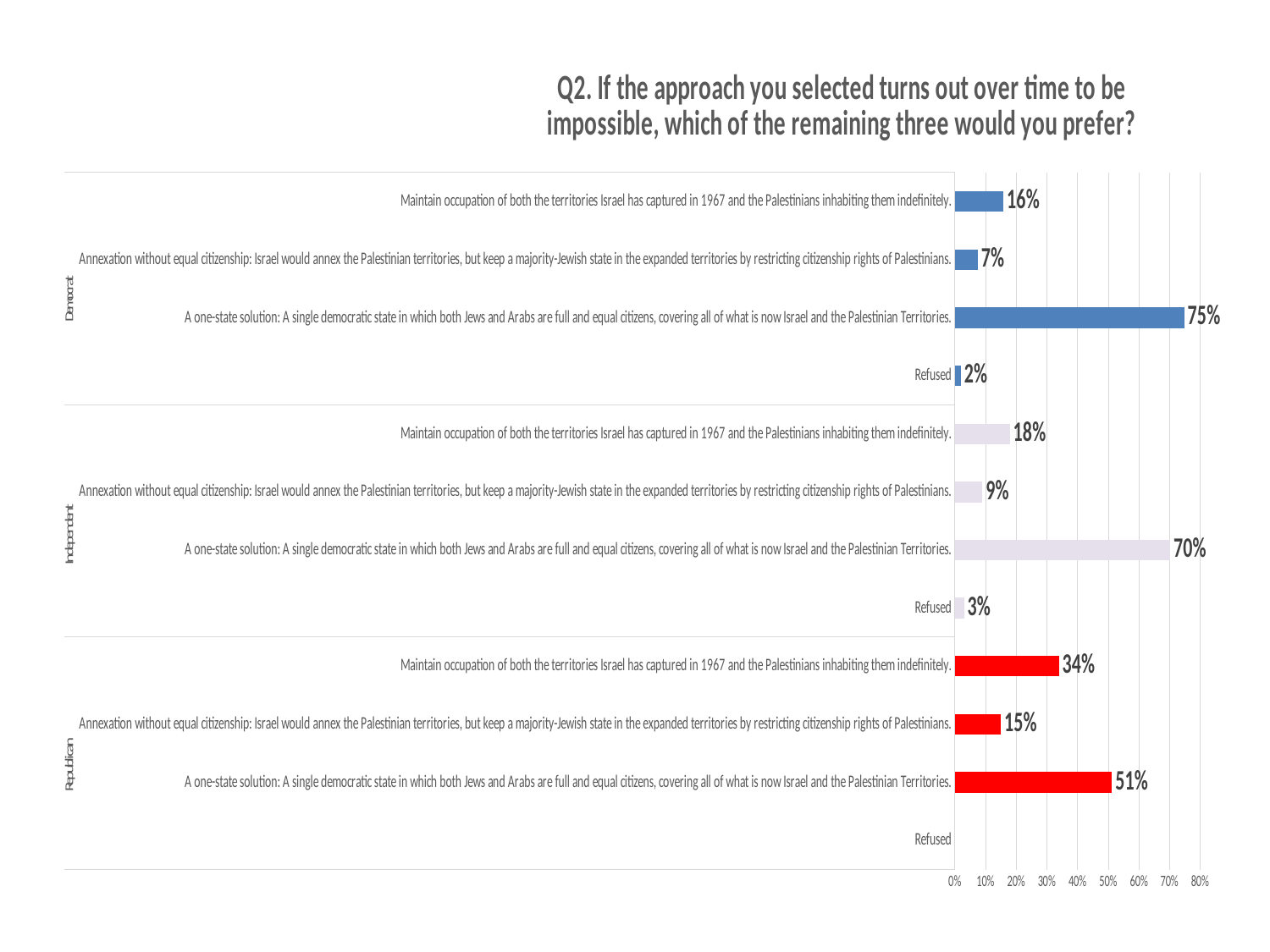
Which group has a higher percentage for annexation without equal citizenship, Democrats or Republicans? Republicans Among Democrats, which option received the lowest percentage? Refused What percentage of Democrats chose the one-state solution? 75% What percentage of Republicans chose to maintain occupation of the territories indefinitely? 34% What percentage of Independents chose annexation without equal citizenship? 9% What percentage of Independents refused to answer? 3% What colour are the bars for the Republican group? Red What is the difference between the Democrat and Republican percentages for the one-state solution? 24% Among Republicans, which option received the highest percentage? A one-state solution How many party groups are shown on the chart? 3 What type of chart is shown on the slide? Bar chart Is the Independent value for the one-state solution greater or less than 60%? greater